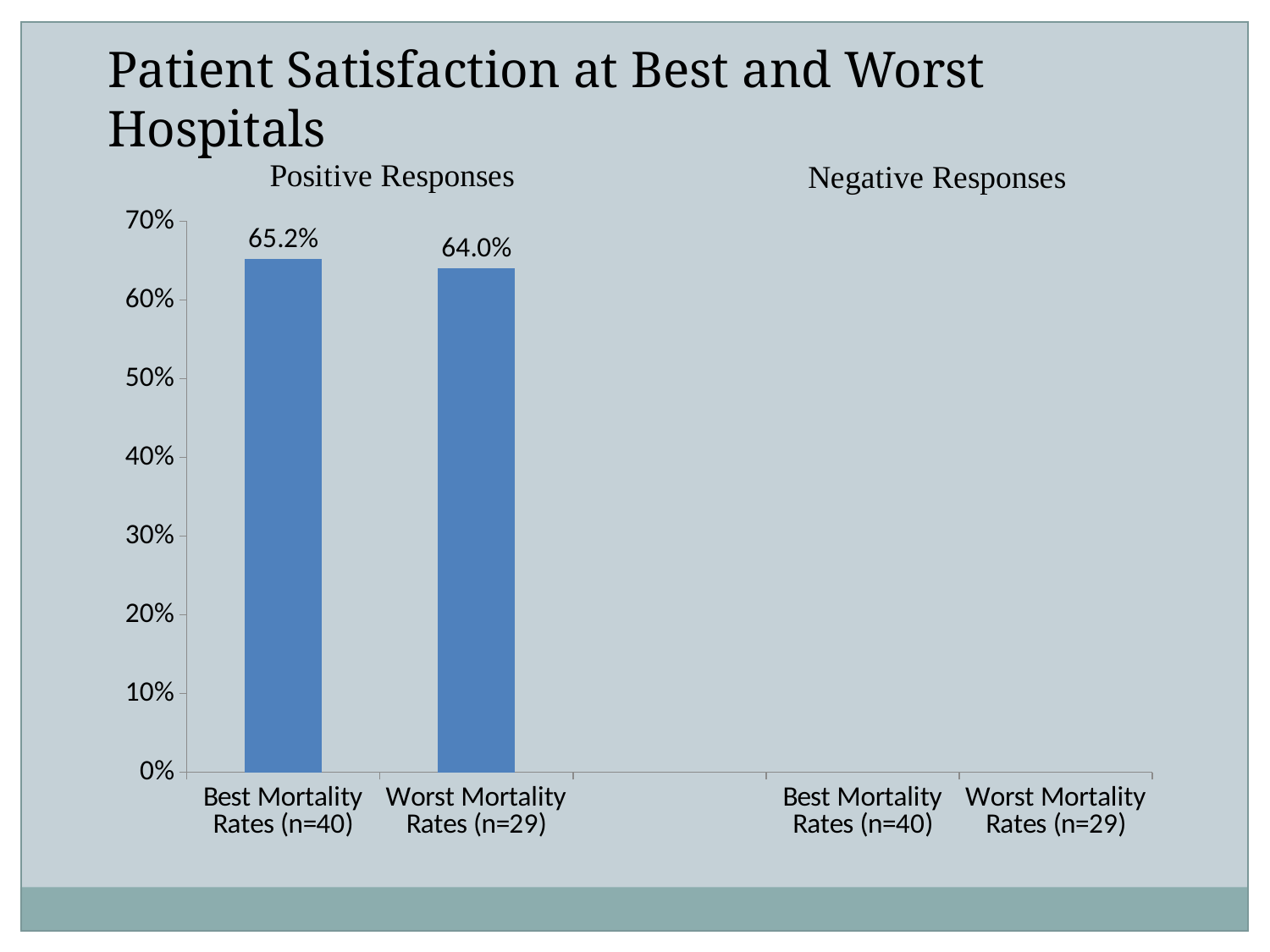
What kind of chart is shown on the slide? bar chart How many bars are plotted on the chart? 2 What is the highest value shown on the vertical axis? 70% What is the difference between the positive response rates for the best and worst mortality rate hospitals? 1.2% Which group has the lowest plotted positive response rate? Worst Mortality Rates (n=29) What is the positive response rate for hospitals with the best mortality rates (n=40)? 65.2% What is the title of the slide? Patient Satisfaction at Best and Worst Hospitals What is the positive response rate for hospitals with the worst mortality rates (n=29)? 64.0% Is the positive response rate for hospitals with the worst mortality rates greater or less than 60%? greater Is the positive response rate for hospitals with the best mortality rates greater or less than 70%? less What are the two group headings shown above the chart? Positive Responses and Negative Responses Which group has the higher positive response rate, best mortality rates or worst mortality rates? Best Mortality Rates (n=40)